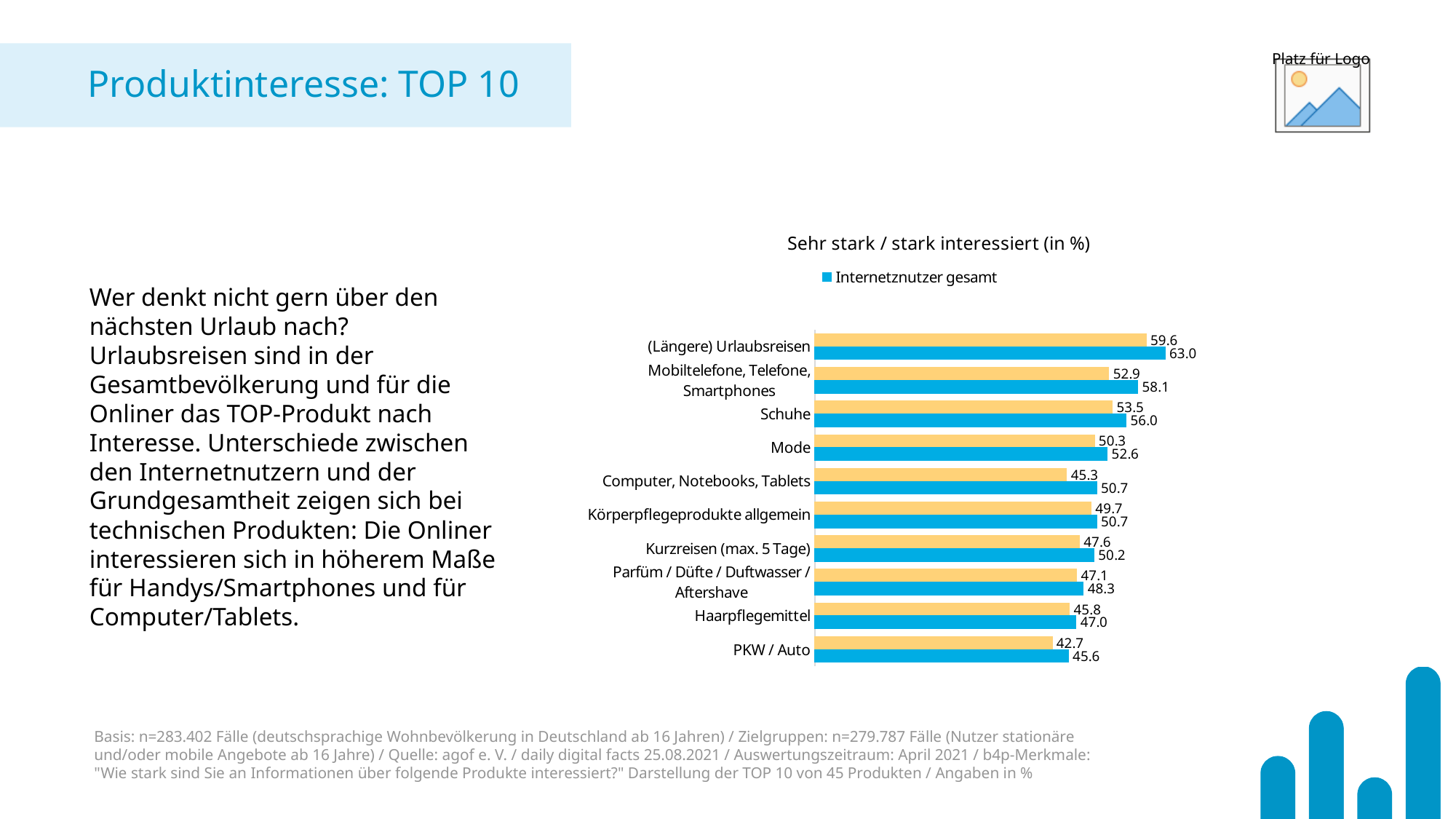
Which has the larger Internetznutzer gesamt value, Kurzreisen (max. 5 Tage) or Haarpflegemittel? Kurzreisen (max. 5 Tage) What is the Internetznutzer gesamt value for Schuhe? 56.0 Which category has the highest Internetznutzer gesamt value? (Längere) Urlaubsreisen How many product categories are shown in the chart? 10 What is the difference between the Internetznutzer gesamt values for (Längere) Urlaubsreisen and Mobiltelefone, Telefone, Smartphones? 4.9 What is the difference between the Internetznutzer gesamt values for Schuhe and PKW / Auto? 10.4 How many series does the chart legend list? 1 What is the title of the chart? Sehr stark / stark interessiert (in %) Which category has the lowest Internetznutzer gesamt value? PKW / Auto What kind of chart is shown on the slide? Bar chart What is the Internetznutzer gesamt value for PKW / Auto? 45.6 What is the Internetznutzer gesamt value for Mode? 52.6